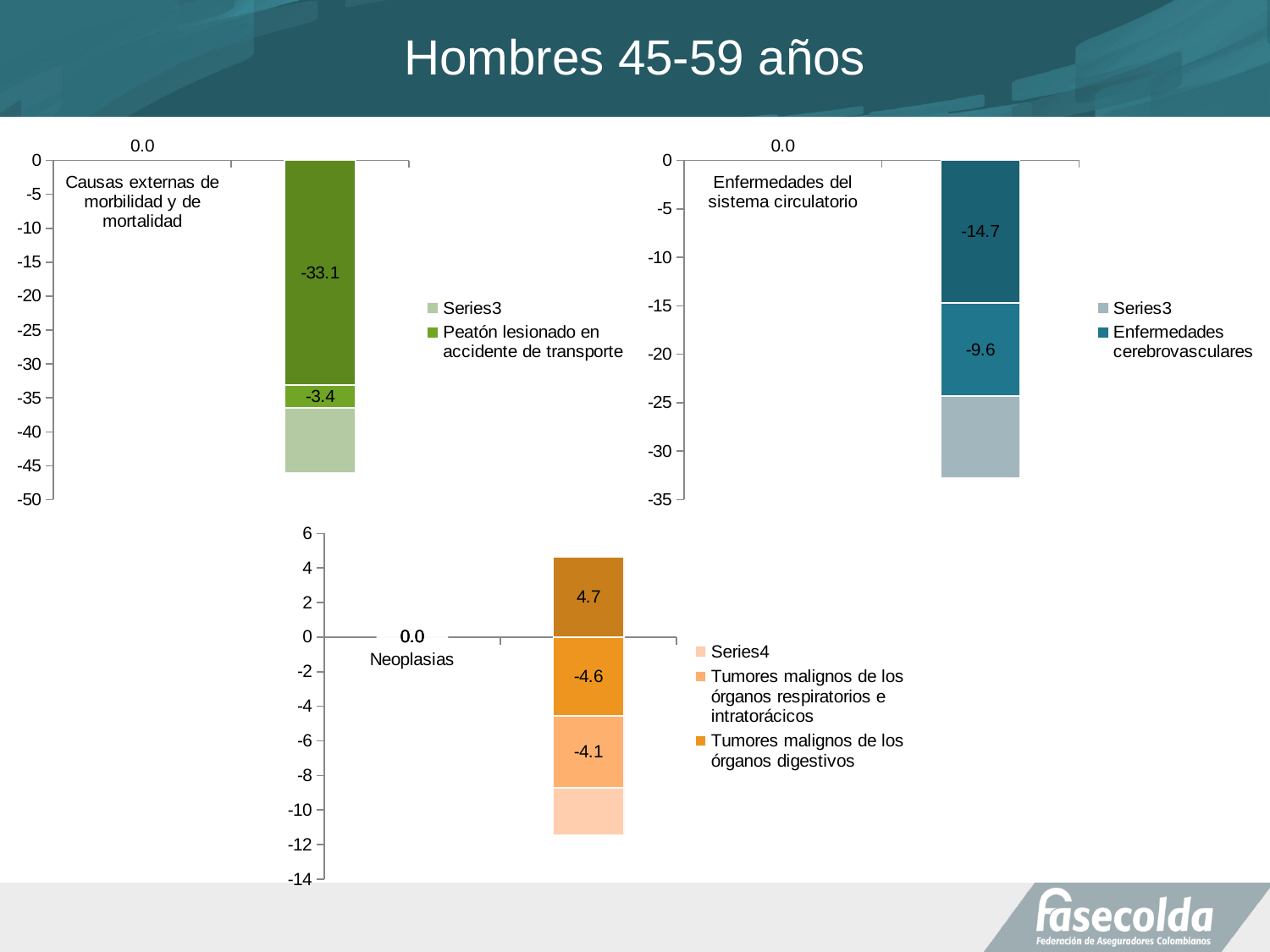
In the top-right chart (Enfermedades del sistema circulatorio), what is the difference between the -14.7 segment and the -9.6 segment? 5.1 How many entries does the legend of the top-right chart (Enfermedades del sistema circulatorio) list? 2 In the top-left chart (Causas externas de morbilidad y de mortalidad), what value is printed on the largest dark green segment? -33.1 What kind of chart is the bottom chart labelled Neoplasias? bar chart In the bottom chart (Neoplasias), what value is printed on the segment directly below the zero line? -4.6 In the top-right chart (Enfermedades del sistema circulatorio), what value is printed on the topmost dark teal segment? -14.7 How many entries does the legend of the bottom chart (Neoplasias) list? 3 What is the title of the slide? Hombres 45-59 años In the bottom chart (Neoplasias), what value is printed on the light orange segment between -4 and -8? -4.1 In the top-left chart (Causas externas de morbilidad y de mortalidad), what value is printed on the small green segment below the -33.1 segment? -3.4 In the top-right chart (Enfermedades del sistema circulatorio), what value is printed on the middle teal segment? -9.6 In the bottom chart (Neoplasias), what value is printed on the segment above the zero line? 4.7